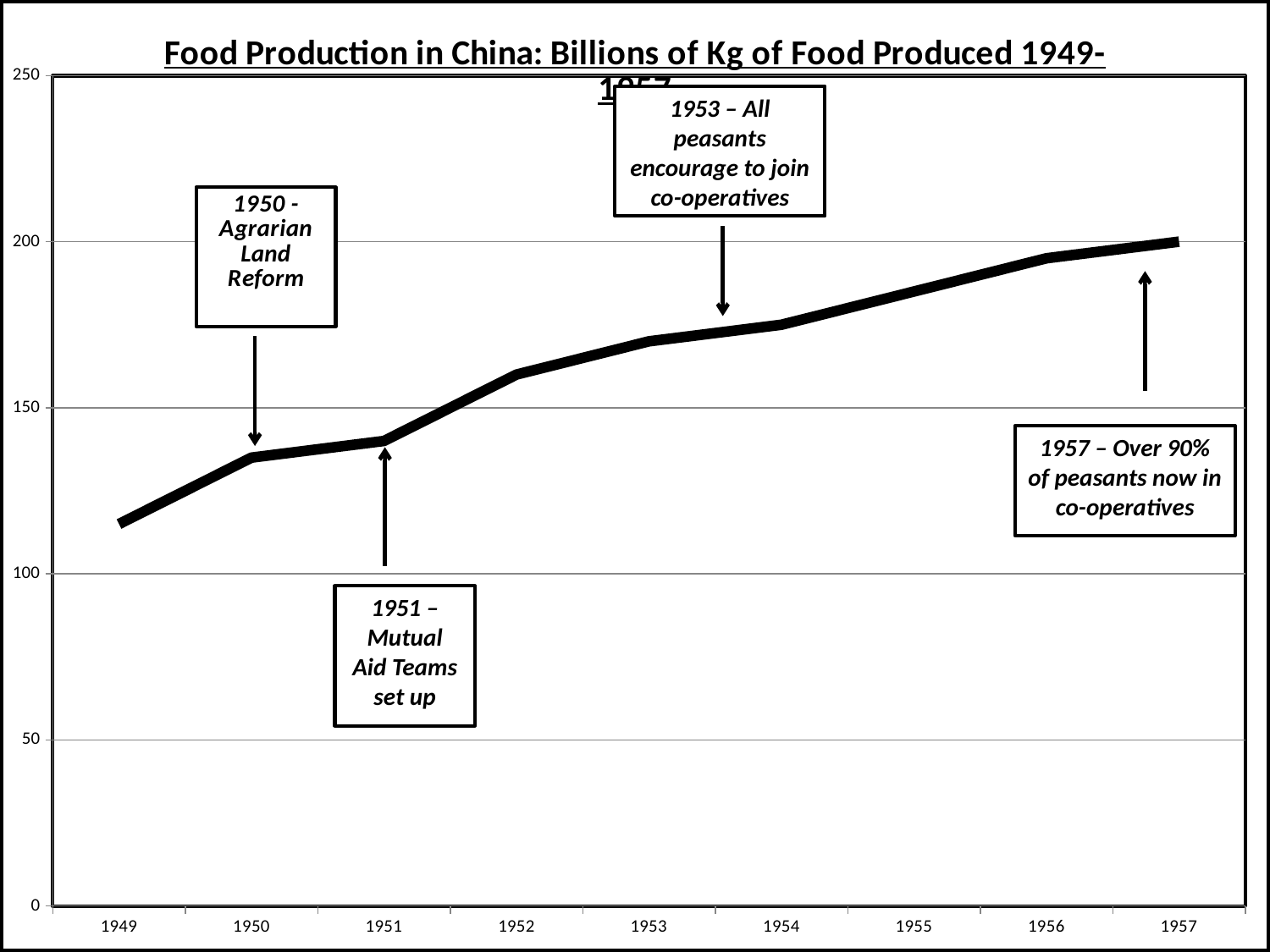
Which year has the larger value, 1950 or 1953? 1953 Is the value for 1955 greater or less than 200? less According to the annotation on the chart, what happened in 1951? Mutual Aid Teams set up Is the value for 1949 greater or less than 100? greater Is the value for 1952 greater or less than 150? greater Which year has the highest food production value? 1957 What kind of chart is shown on the slide? line chart Which year has the lowest food production value? 1949 Do the values rise or fall from 1949 to 1957? rise How many years are plotted along the x axis? 9